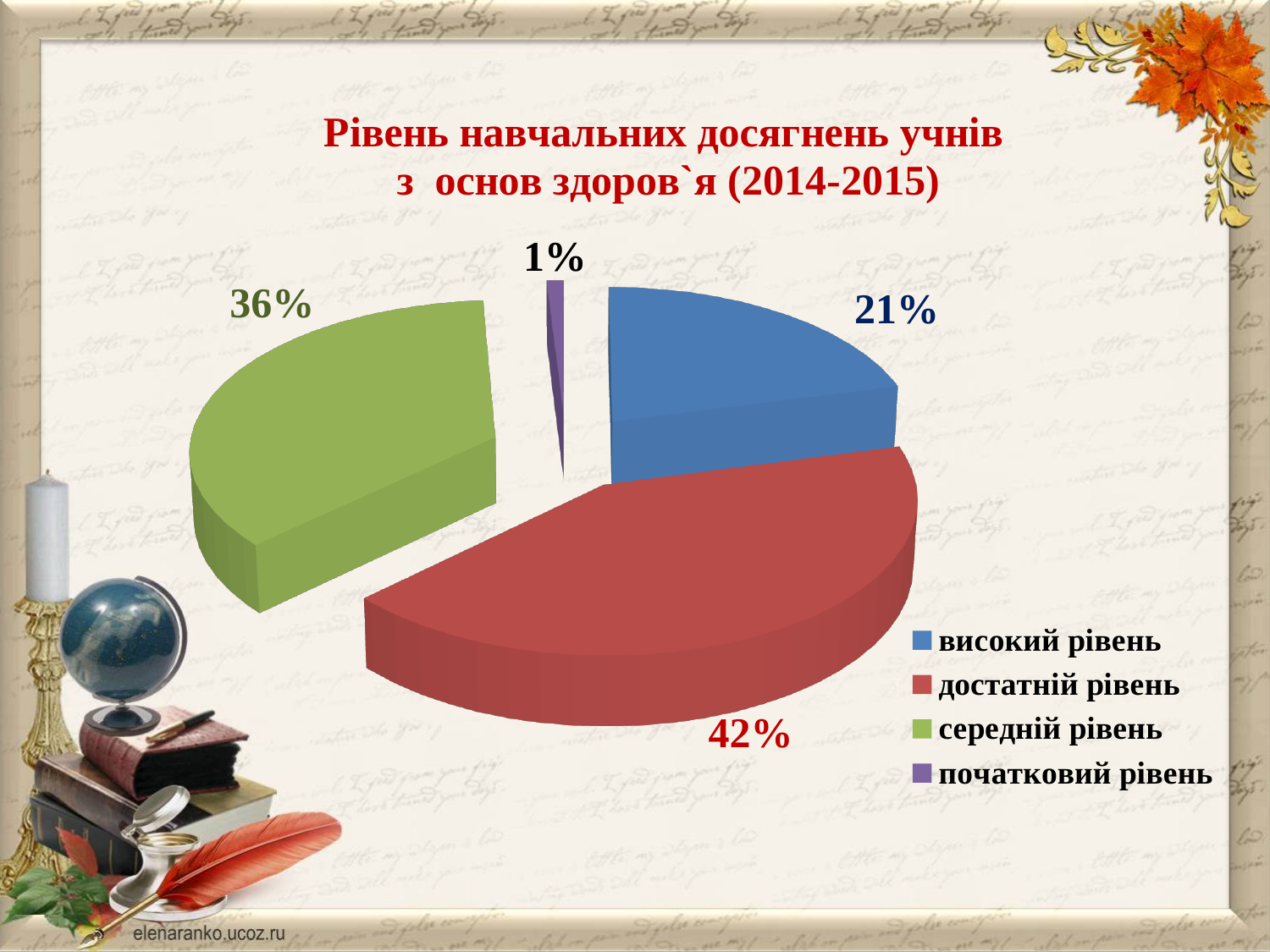
Which category has the smallest slice of the pie? початковий рівень What kind of chart is shown on the slide? pie chart What colour is the slice for "середній рівень"? green Which is larger, the share of "високий рівень" or the share of "середній рівень"? середній рівень How many entries does the legend list? 4 What share of the pie does "середній рівень" have? 36% What share of the pie does "достатній рівень" have? 42% How many slices does the pie chart have? 4 Which category has the largest slice of the pie? достатній рівень What is the difference between the shares of "достатній рівень" and "середній рівень"? 6% What share of the pie does "високий рівень" have? 21%